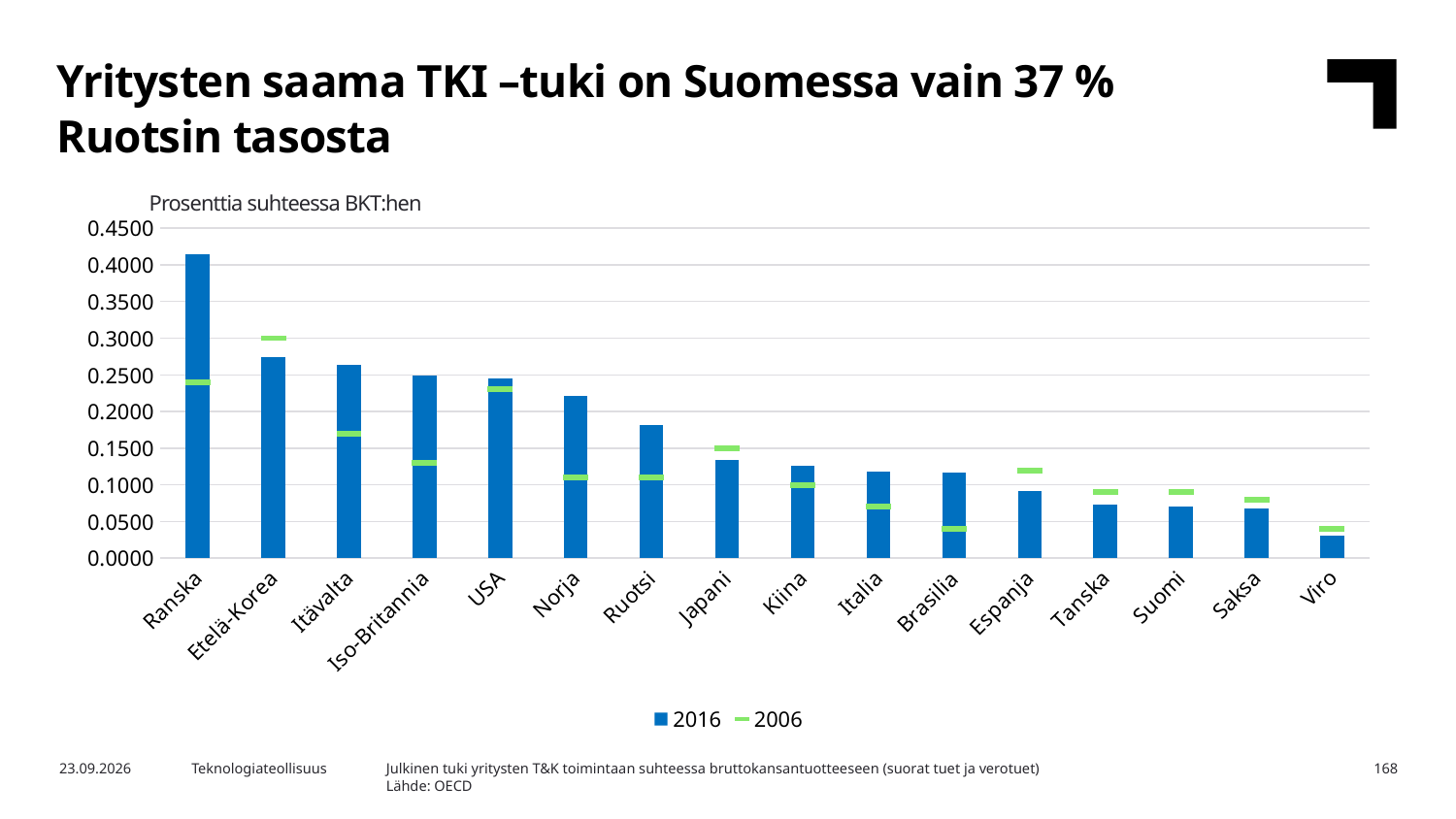
Is the 2016 value for Suomi greater or less than 0.1000? less Which has the larger 2016 value, Ruotsi or Suomi? Ruotsi How many series does the chart legend list? 2 Do the 2016 bars rise or fall from left to right along the x axis? fall What is the axis label shown above the chart's vertical axis? Prosenttia suhteessa BKT:hen Which country has the highest 2016 value in the chart? Ranska Which country has the lowest 2016 value in the chart? Viro What kind of chart is shown on the slide? bar chart How many countries are shown on the x axis of the chart? 16 Is the 2016 value for Ruotsi greater or less than 0.1500? greater Is the 2016 value for Ranska greater or less than 0.4000? greater